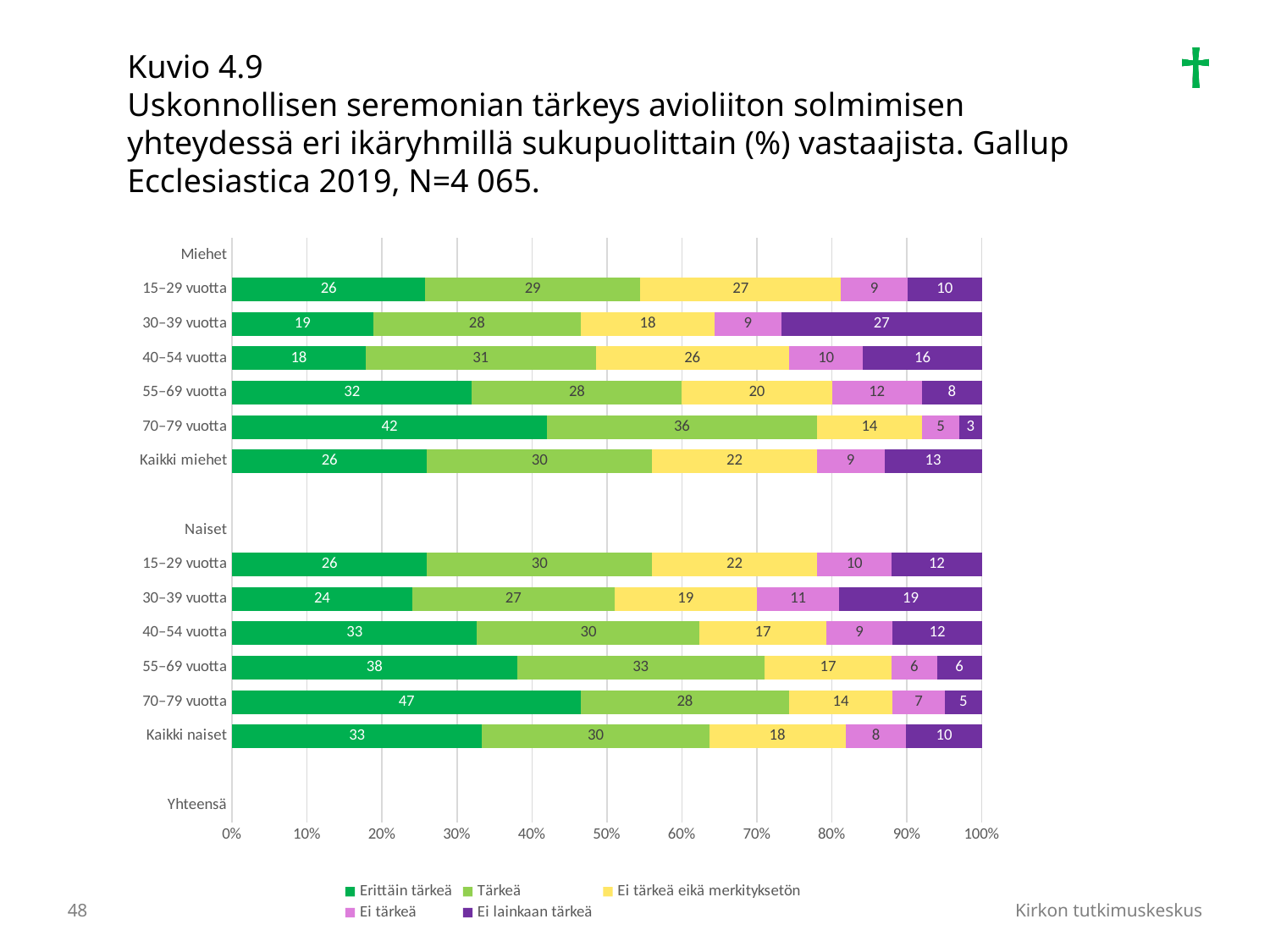
What is the value of "Ei tärkeä eikä merkityksetön" for Kaikki naiset? 18 What is the value of "Erittäin tärkeä" for men (Miehet) aged 70–79 vuotta? 42 What is the value of "Tärkeä" for women (Naiset) aged 55–69 vuotta? 33 Which legend entry is shown in dark purple? Ei lainkaan tärkeä Among the men's (Miehet) age groups, which has the lowest value for "Ei lainkaan tärkeä"? 70–79 vuotta How many series does the legend list? 5 Which is larger: the "Ei lainkaan tärkeä" value for men aged 15–29 vuotta or for women aged 15–29 vuotta? Women aged 15–29 vuotta (12) Among the women's (Naiset) age groups, which has the highest value for "Erittäin tärkeä"? 70–79 vuotta What is the difference between the "Erittäin tärkeä" values for Kaikki naiset and Kaikki miehet? 7 What kind of chart is shown on the slide? Stacked bar chart How many age groups are shown for men (Miehet), excluding the Kaikki miehet total? 5 What is the value of "Ei lainkaan tärkeä" for men (Miehet) aged 30–39 vuotta? 27